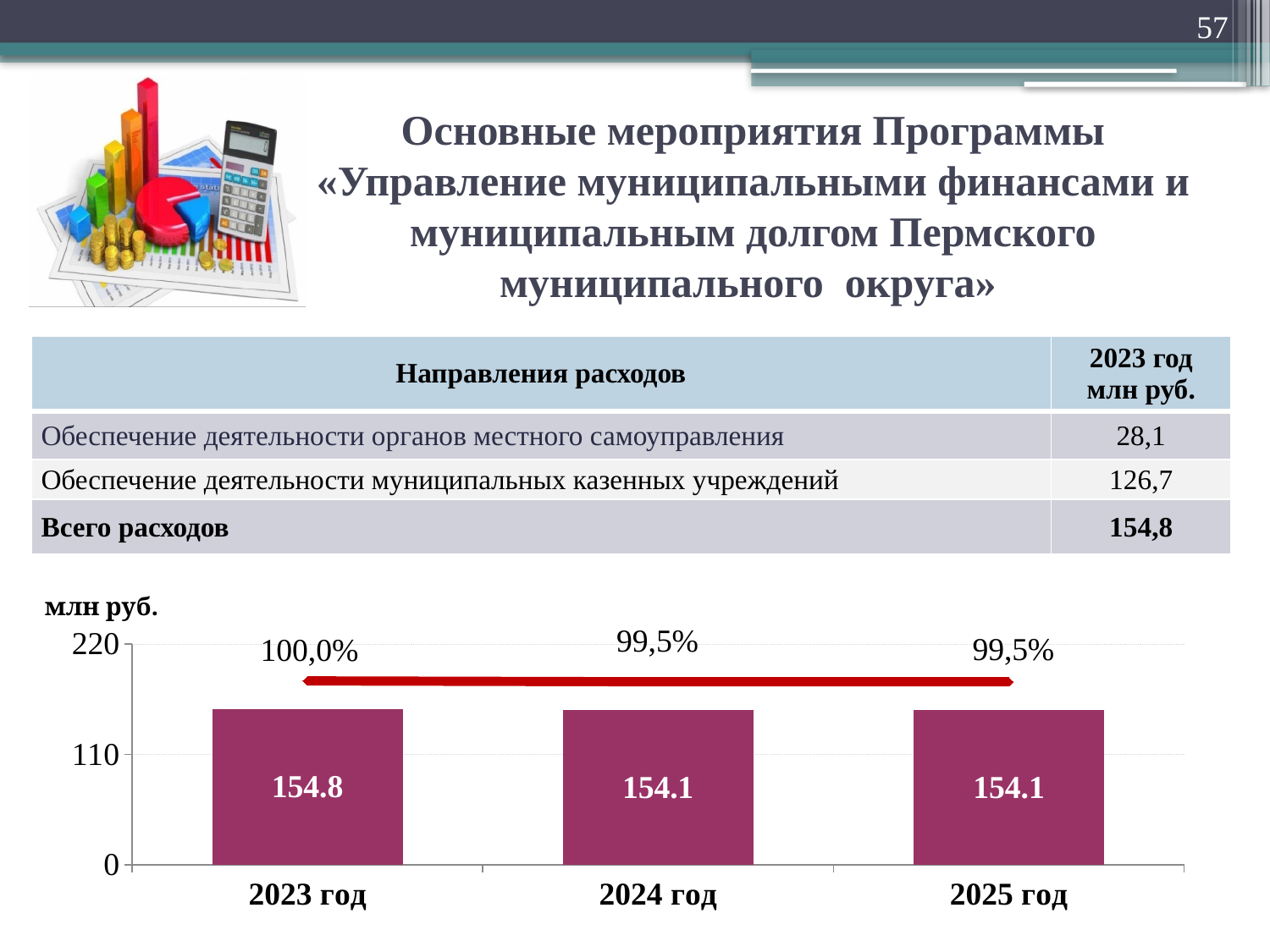
Is the value for 2025 год in the bar chart greater or less than 220? less Which year has the highest value in the bar chart? 2023 год Is the value for 2024 год in the bar chart greater or less than 110? greater What percentage label is shown above the 2024 год bar in the chart? 99,5% How many bars are shown in the bar chart? 3 What is the difference between the values for 2023 год and 2024 год in the bar chart? 0.7 What is the value for 2024 год in the bar chart? 154.1 What is the value for 2023 год in the bar chart? 154.8 Do the values in the bar chart rise or fall from 2023 год to 2024 год? fall What kind of chart is shown at the bottom of the slide? bar chart Which is larger in the bar chart, the value for 2023 год or the value for 2025 год? 2023 год What is the value for 2025 год in the bar chart? 154.1